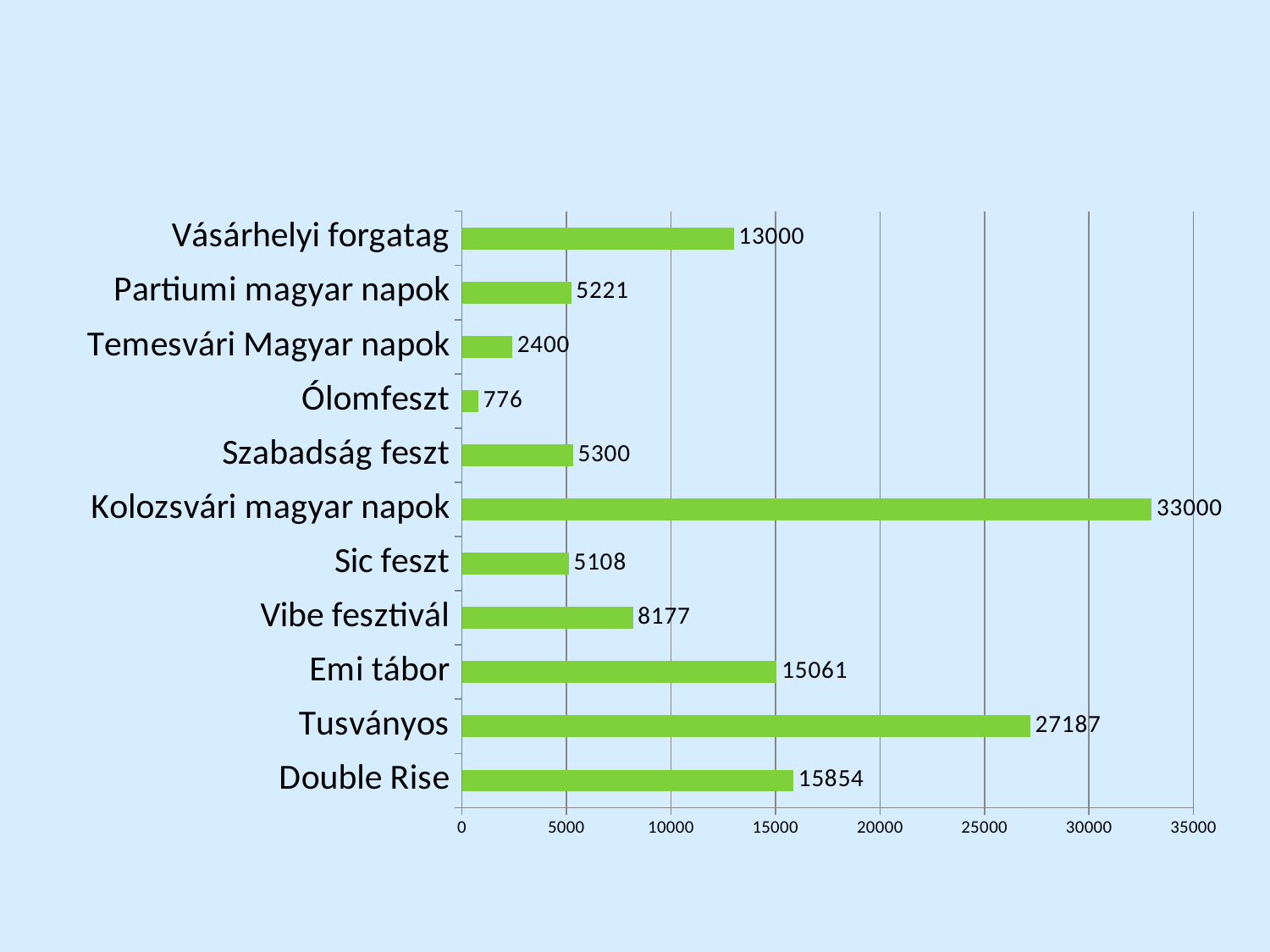
How many categories are shown in the chart? 11 What kind of chart is shown on the slide? bar chart Which is larger, the value for Vásárhelyi forgatag or the value for Emi tábor? Emi tábor Which category has the lowest value? Ólomfeszt What is the value for Tusványos? 27187 What is the difference between the values for Kolozsvári magyar napok and Tusványos? 5813 What is the value for Vibe fesztivál? 8177 What is the maximum value shown on the horizontal axis? 35000 What is the difference between the values for Double Rise and Emi tábor? 793 What is the value for Ólomfeszt? 776 Is the value for Tusványos greater or less than 25000? greater Which category has the highest value? Kolozsvári magyar napok